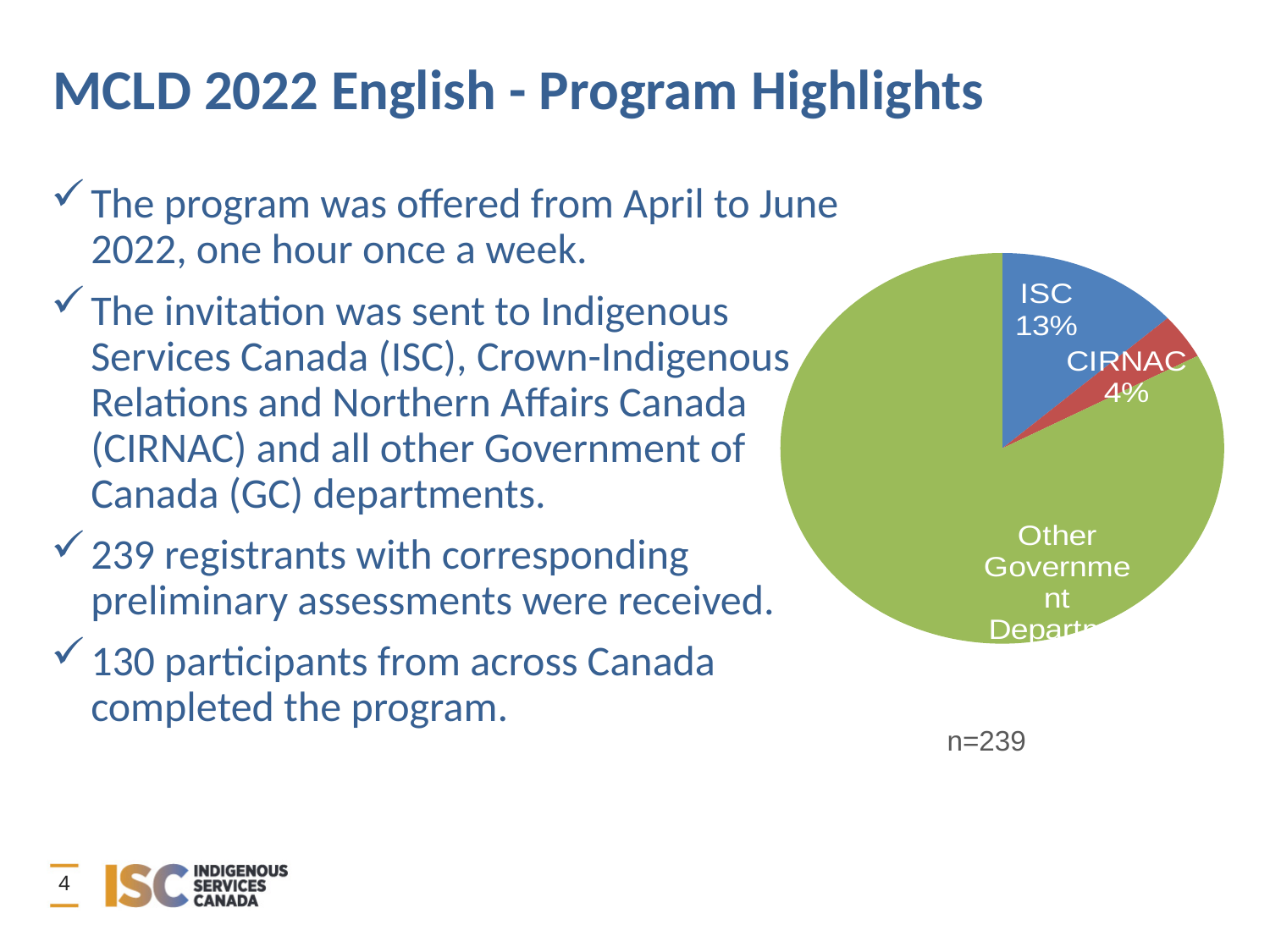
What colour is the ISC slice in the pie chart? Blue What share of the pie does the ISC slice represent? 13% What percentage of registrants came from ISC according to the pie chart? 13% Which slice of the pie chart is the largest? Other Government Departments What kind of chart is shown on the slide? Pie chart Which slice of the pie chart is the smallest? CIRNAC Which is larger in the pie chart, the ISC slice or the CIRNAC slice? ISC What percentage of registrants came from CIRNAC according to the pie chart? 4% What sample size (n) is noted below the pie chart? n=239 How many slices does the pie chart have? 3 By how many percentage points does the ISC share exceed the CIRNAC share in the pie chart? 9 percentage points